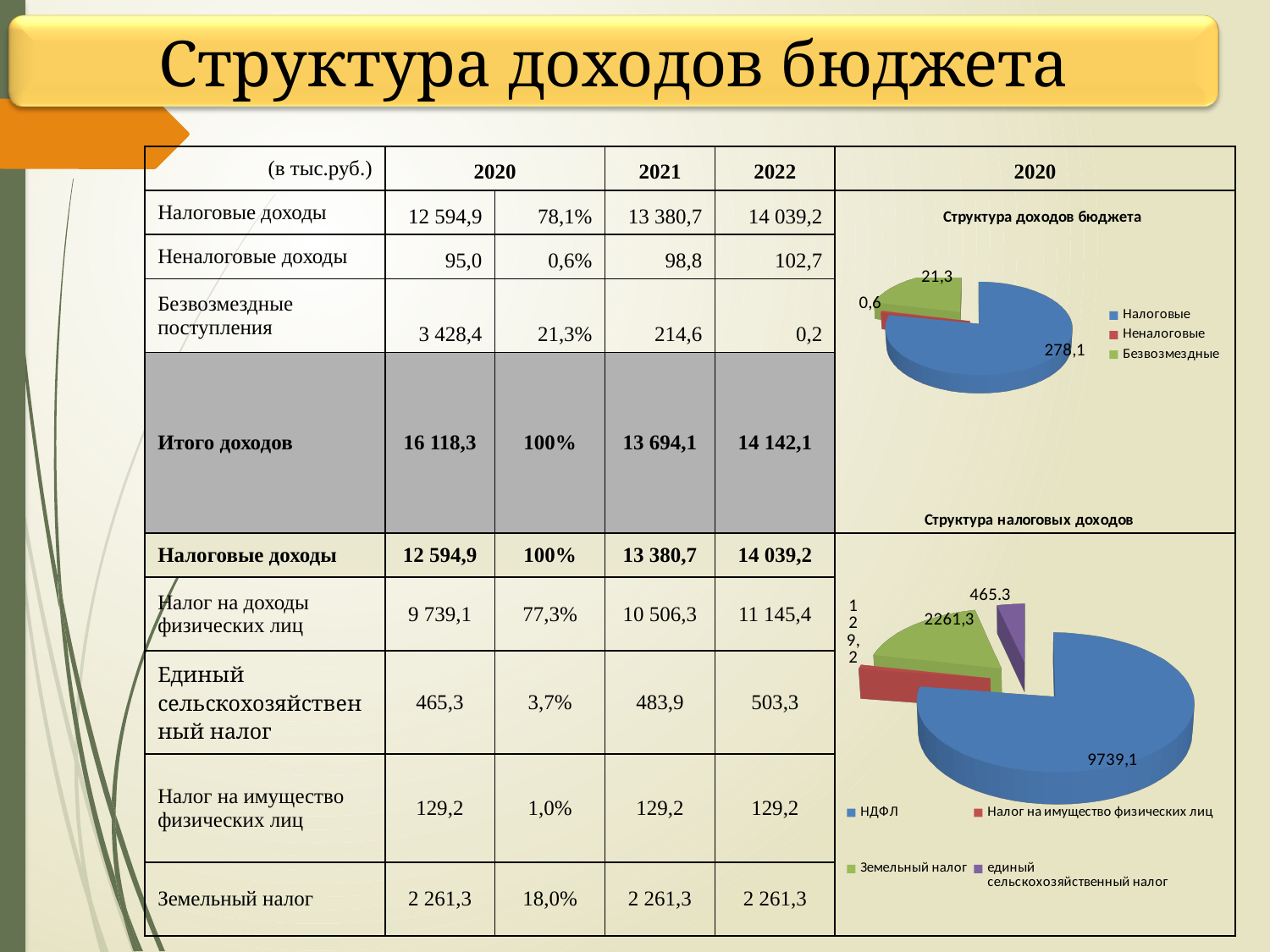
In the bottom chart "Структура налоговых доходов", what value is labelled on the НДФЛ slice? 9739,1 In the top chart "Структура доходов бюджета", how many entries does the legend list? 3 What kind of chart is the bottom chart titled "Структура налоговых доходов"? pie chart In the top chart "Структура доходов бюджета", what value is labelled on the Неналоговые slice? 0,6 In the bottom chart "Структура налоговых доходов", what value is labelled on the Земельный налог slice? 2261,3 In the bottom chart "Структура налоговых доходов", how many entries does the legend list? 4 What kind of chart is the top chart titled "Структура доходов бюджета"? pie chart In the top chart "Структура доходов бюджета", which category has the smallest slice? Неналоговые In the top chart "Структура доходов бюджета", which category has the largest slice? Налоговые In the bottom chart "Структура налоговых доходов", what colour is the НДФЛ slice? blue In the bottom chart "Структура налоговых доходов", which is larger: the Земельный налог slice or the единый сельскохозяйственный налог slice? Земельный налог In the top chart "Структура доходов бюджета", what value is labelled on the Безвозмездные slice? 21,3